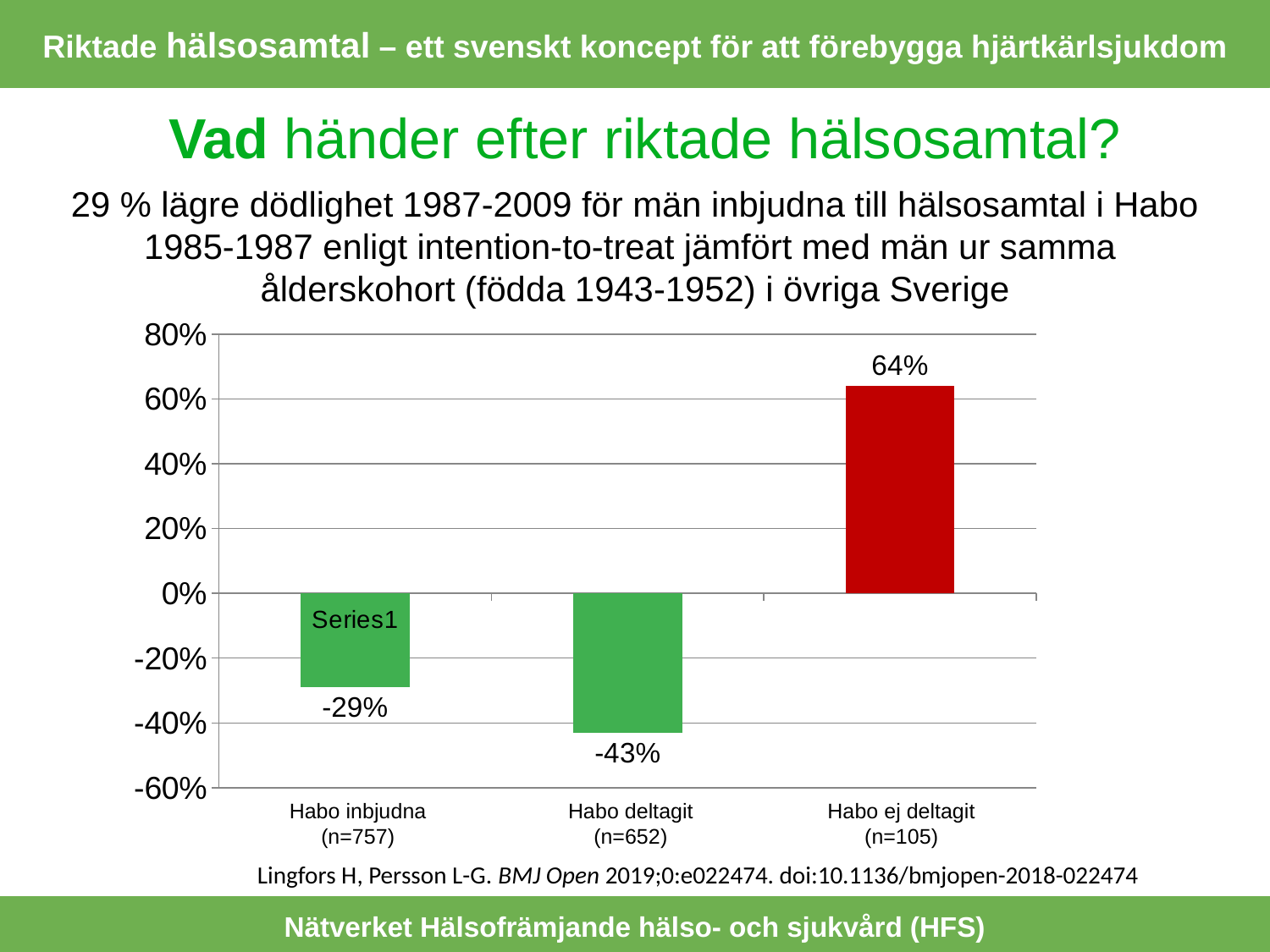
What is the difference between the values for Habo ej deltagit and Habo inbjudna? 93 percentage points What is the value for Habo ej deltagit (n=105)? 64% What is the value for Habo deltagit (n=652)? -43% Is the value for Habo ej deltagit greater or less than 60%? greater What is the value for Habo inbjudna (n=757)? -29% How many categories are shown on the x axis? 3 Which category has the highest value? Habo ej deltagit (n=105) Which is larger, the value for Habo inbjudna or the value for Habo deltagit? Habo inbjudna What is the difference between the values for Habo inbjudna and Habo deltagit? 14 percentage points Which category has the lowest value? Habo deltagit (n=652) What colour is the bar for Habo ej deltagit? Red What kind of chart is shown on the slide? Bar chart